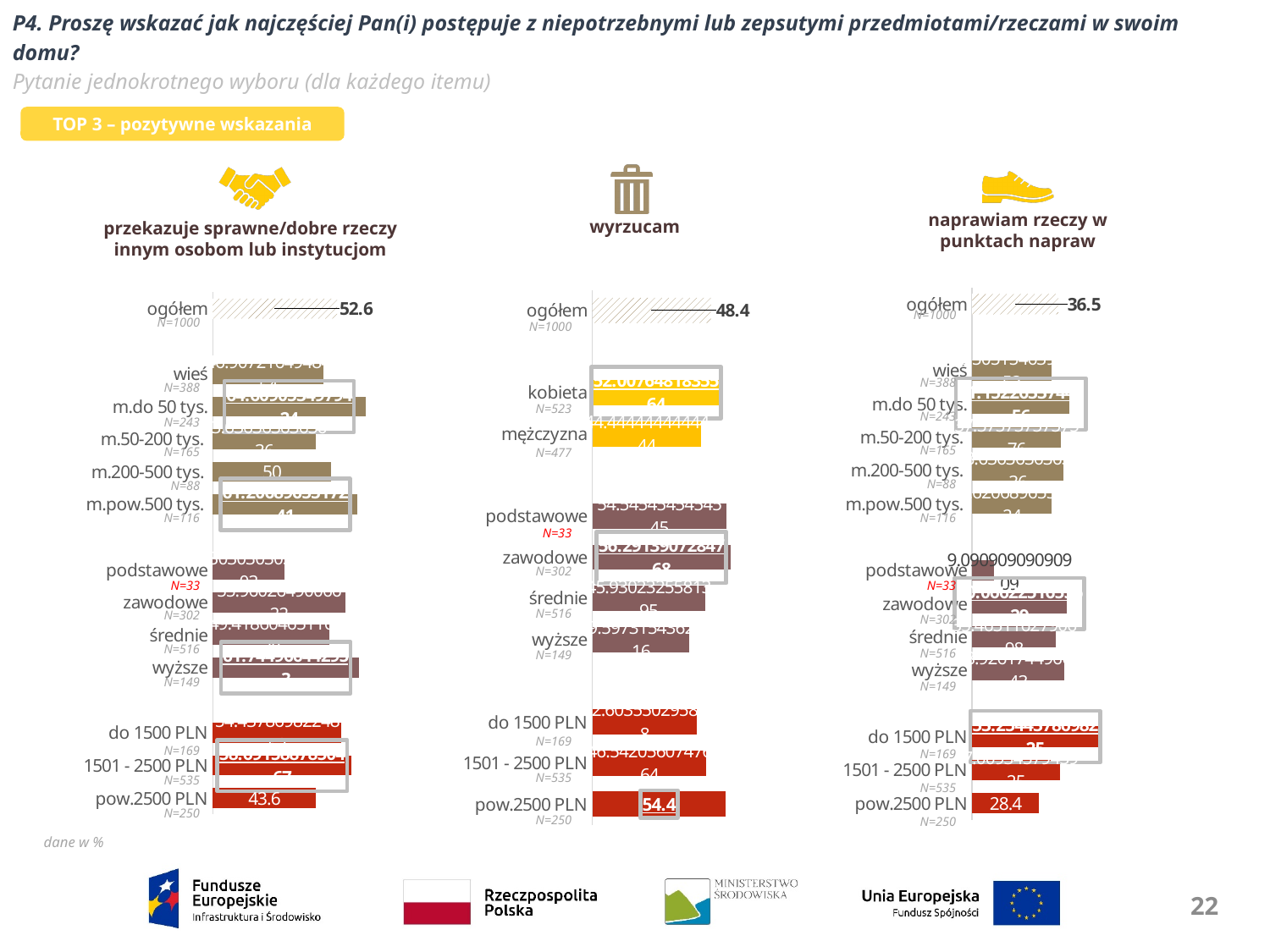
In the chart titled 'naprawiam rzeczy w punktach napraw', what is the difference between the value for 'ogółem' and the value for 'pow.2500 PLN'? 8.1 In the chart titled 'naprawiam rzeczy w punktach napraw', what is the value for 'ogółem'? 36.5 In the chart titled 'wyrzucam', what is the difference between the value for 'pow.2500 PLN' and the value for 'ogółem'? 6 In the chart titled 'przekazuje sprawne/dobre rzeczy innym osobom lub instytucjom', what is the value for 'ogółem'? 52.6 In the chart titled 'wyrzucam', which is larger: the value for 'pow.2500 PLN' or the value for 'ogółem'? pow.2500 PLN In the chart titled 'wyrzucam', what is the value for 'ogółem'? 48.4 In the chart titled 'przekazuje sprawne/dobre rzeczy innym osobom lub instytucjom', what is the value for 'm.200-500 tys.'? 50 What kind of chart is the chart titled 'wyrzucam'? bar chart In the chart titled 'naprawiam rzeczy w punktach napraw', what is the value for 'pow.2500 PLN'? 28.4 In the chart titled 'przekazuje sprawne/dobre rzeczy innym osobom lub instytucjom', what is the value for 'pow.2500 PLN'? 43.6 How many charts are shown on the slide? 3 In the chart titled 'wyrzucam', what is the value for 'pow.2500 PLN'? 54.4